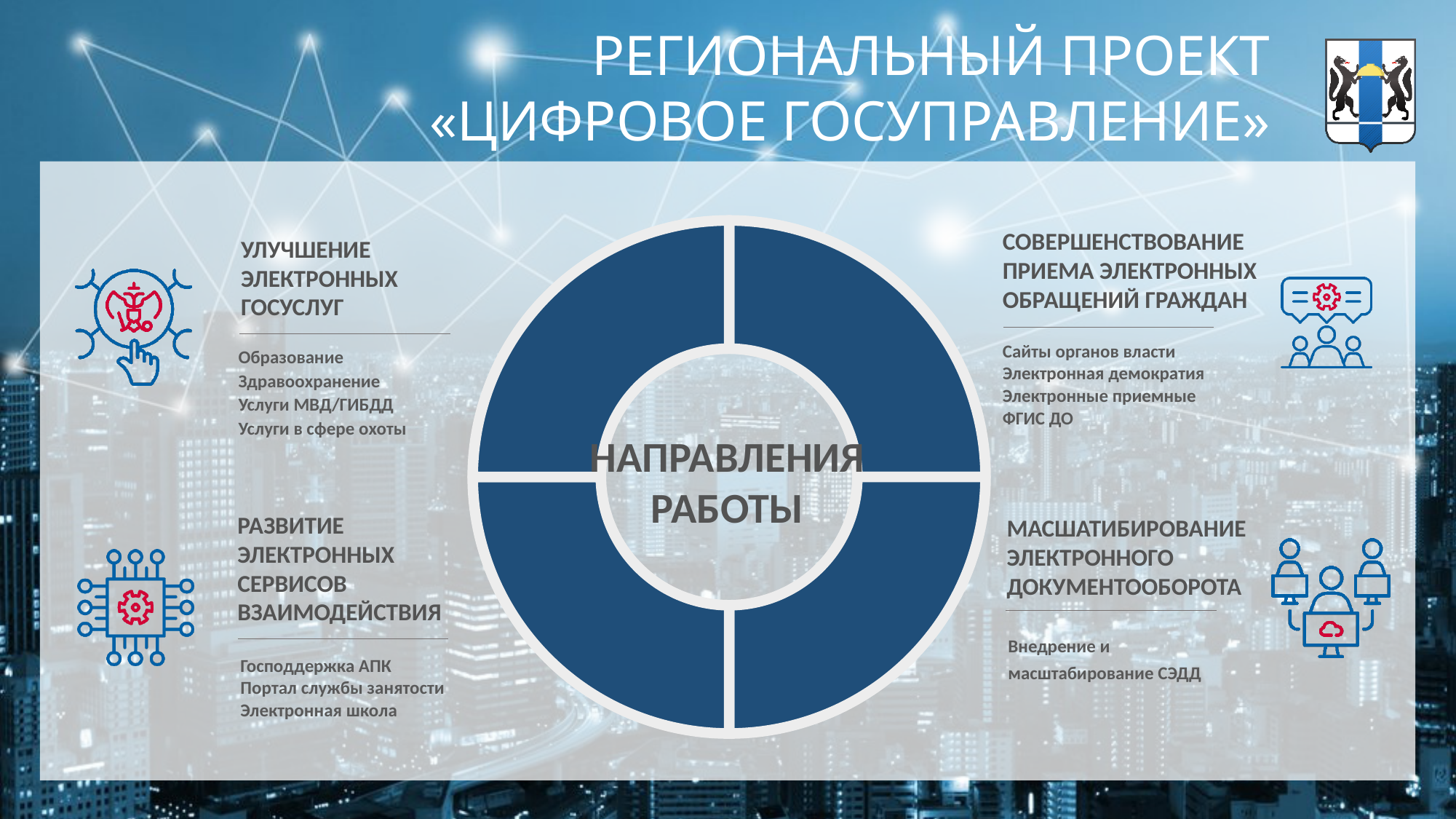
What colour are the segments of the ring diagram? Dark blue How many segments does the ring diagram in the centre of the slide have? 4 What text is written in the centre of the ring diagram? НАПРАВЛЕНИЯ РАБОТЫ Are the four segments of the ring diagram equal in size, or is one larger than the others? Equal